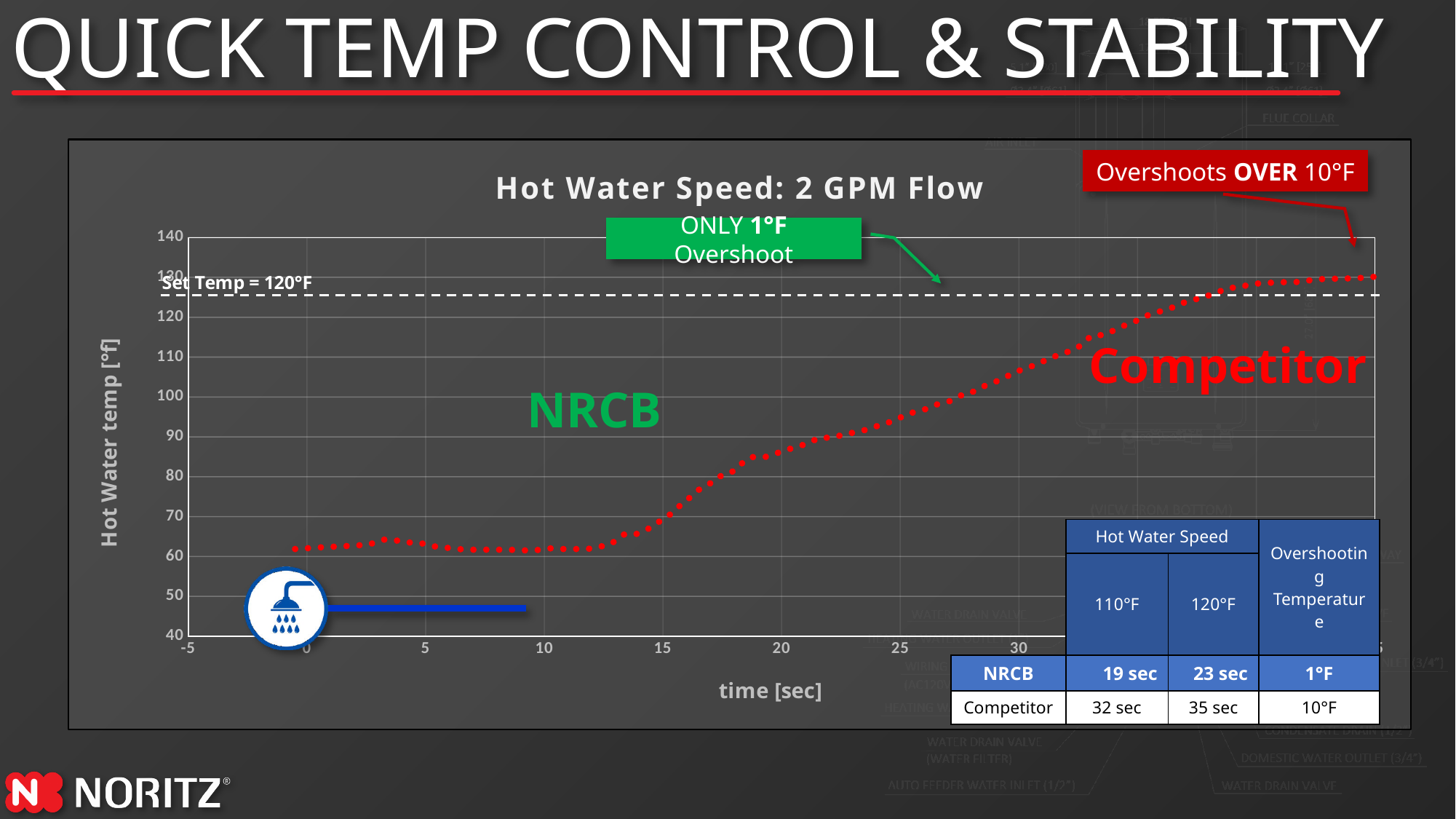
What is the label of the vertical axis of the chart? Hot Water temp [°f] What kind of chart is shown on the slide? line chart What set temperature is marked by the dashed line on the chart? 120°F Which has the smaller overshooting temperature, NRCB or Competitor? NRCB Is the Competitor hot water temperature at time 0 sec greater or less than 70? less According to the table, what is the overshooting temperature of the Competitor? 10°F How many seconds faster does the NRCB reach 110°F than the Competitor, according to the table? 13 sec According to the table, how many seconds does the NRCB take to reach 120°F? 23 sec Is the Competitor hot water temperature at time 30 sec greater or less than 100? greater According to the table, how many seconds does the Competitor take to reach 110°F? 32 sec What is the title of the chart? Hot Water Speed: 2 GPM Flow Does the Competitor line rise or fall as time increases along the x axis? rise